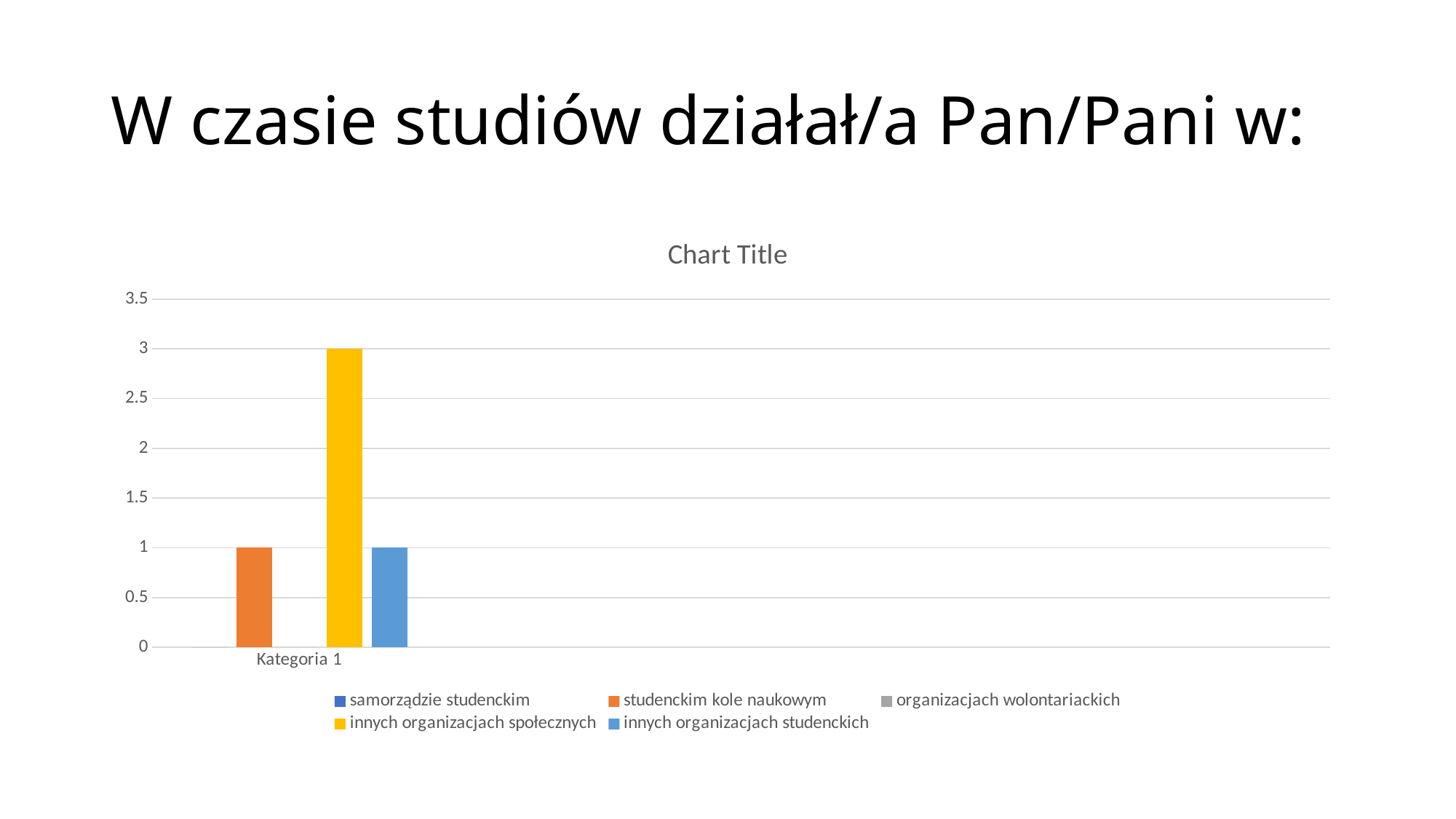
Which is larger: the value for 'innych organizacjach społecznych' or the value for 'innych organizacjach studenckich'? innych organizacjach społecznych What is the title shown above the chart? Chart Title Is the value for 'innych organizacjach społecznych' greater or less than 2? greater What is the value for 'innych organizacjach studenckich' in Kategoria 1? 1 What kind of chart is shown on the slide? bar chart What is the value for 'innych organizacjach społecznych' in Kategoria 1? 3 Which series has the highest bar in Kategoria 1? innych organizacjach społecznych What is the difference between the values for 'innych organizacjach społecznych' and 'studenckim kole naukowym'? 2 What colour is the bar for 'innych organizacjach społecznych'? yellow What is the value for 'studenckim kole naukowym' in Kategoria 1? 1 How many categories are shown on the x axis? 1 How many series does the legend list? 5